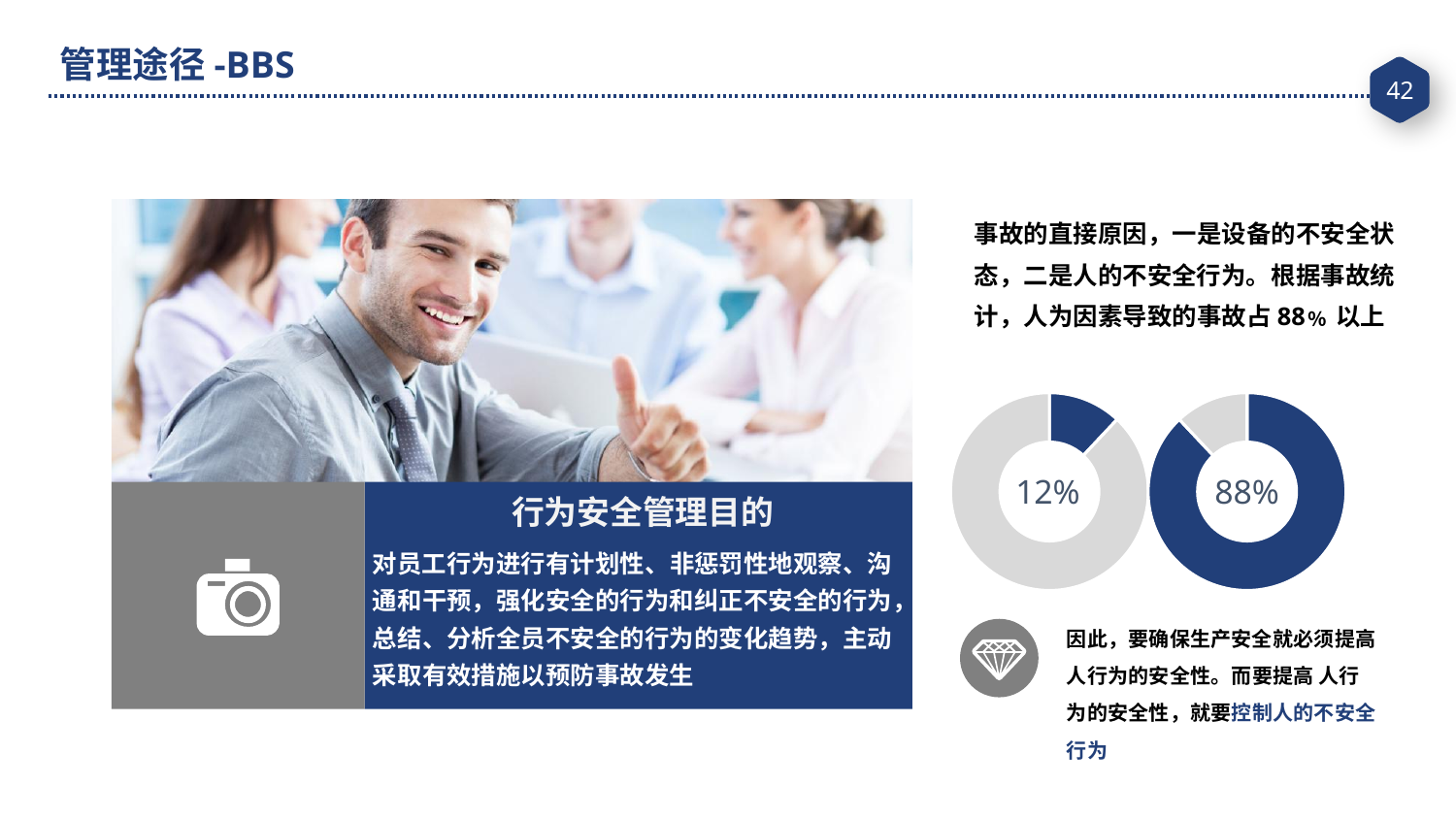
What share of the right doughnut chart is filled with the dark blue segment? 88% Which doughnut chart shows the larger value, the left one or the right one? The right one What do the values of the left and right doughnut charts add up to? 100% What value is printed in the centre of the left doughnut chart? 12% What kind of chart are the two charts on the right side of the slide? Doughnut (pie) charts What colour is the remaining (non-highlighted) portion of each doughnut chart? Light grey What colour is the highlighted segment in both doughnut charts? Dark blue Is the value shown in the left doughnut chart greater or less than 50%? less What value is printed in the centre of the right doughnut chart? 88% What is the difference between the value in the right doughnut chart and the value in the left doughnut chart? 76% Is the value shown in the right doughnut chart greater or less than 50%? greater How many doughnut charts are shown on the slide? 2